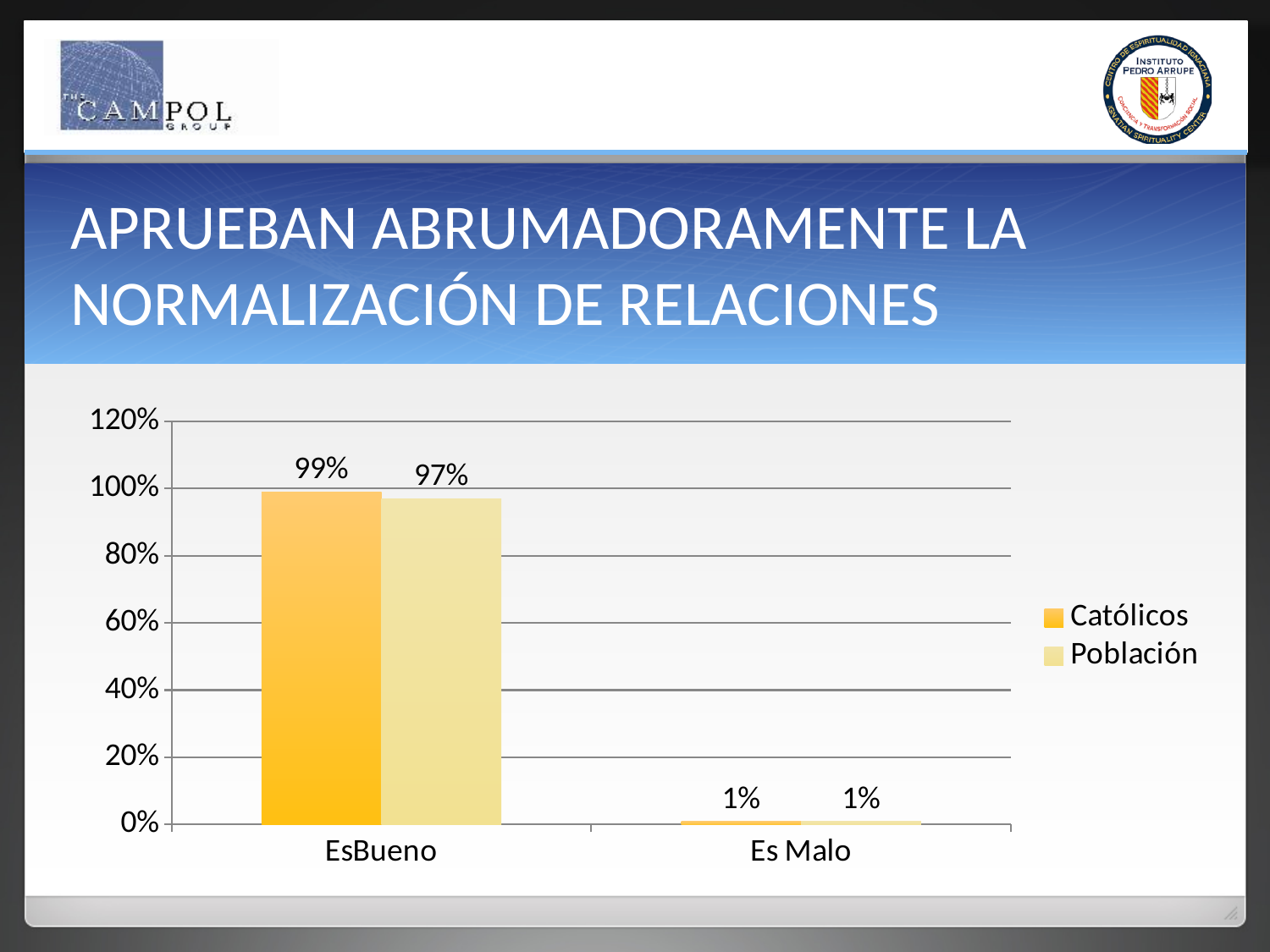
What is the difference between the Católicos and Población values in the EsBueno category? 2% How many categories are shown on the x axis? 2 Which category has the highest value for Católicos? EsBueno Is the value for Población in the EsBueno category greater or less than 80%? greater What is the value for Población in the Es Malo category? 1% In the EsBueno category, which series has the larger value, Católicos or Población? Católicos What is the value for Católicos in the Es Malo category? 1% What is the value for Católicos in the EsBueno category? 99% Which category has the lowest value for Población? Es Malo What kind of chart is shown on the slide? bar chart What is the value for Población in the EsBueno category? 97% How many series does the legend list? 2